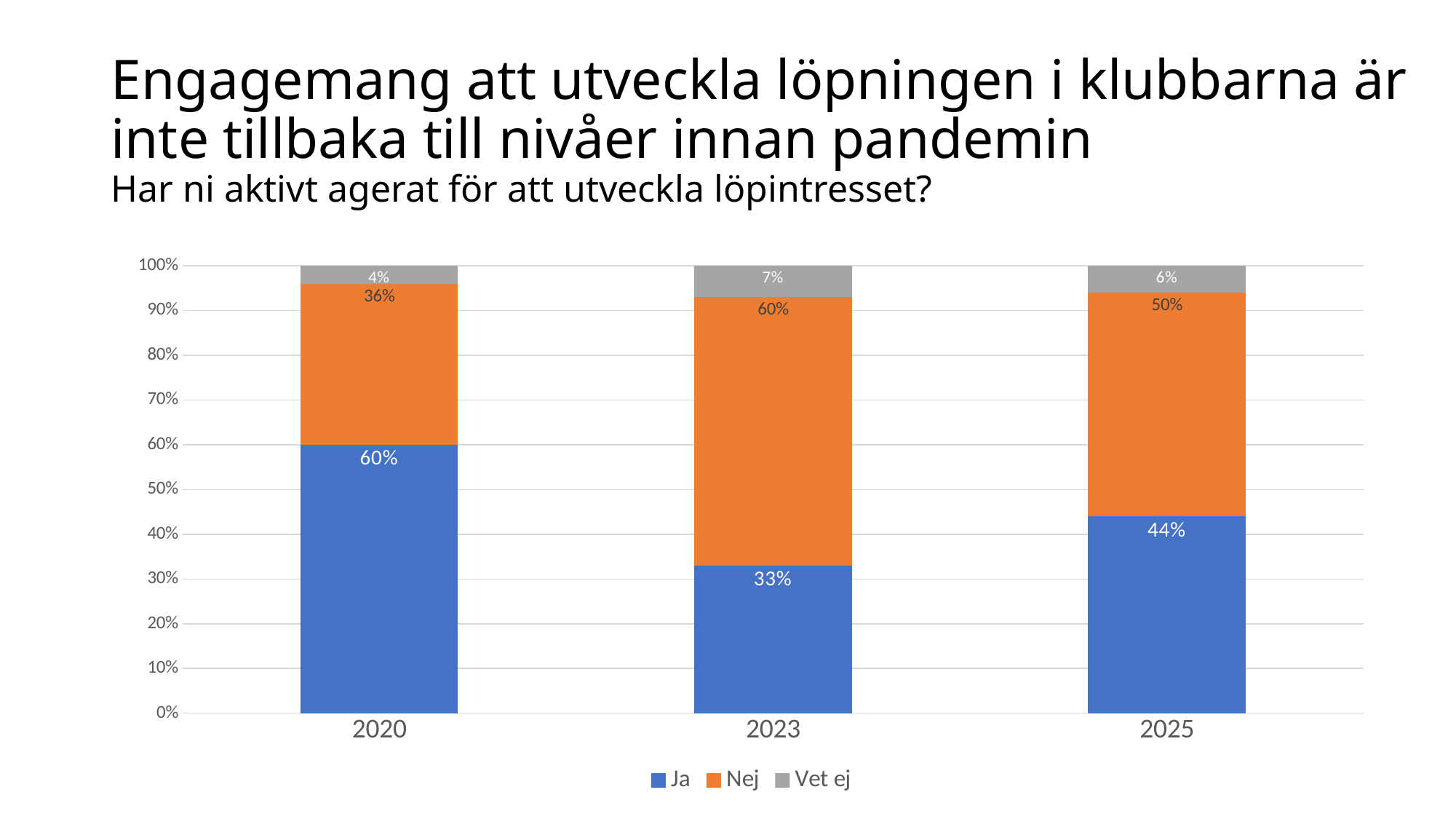
What is the value for Vet ej in 2025? 6% In which year is the Ja share lowest? 2023 What is the value for Ja in 2020? 60% Which colour represents Nej in the chart? Orange What is the difference between the Ja value in 2020 and the Ja value in 2023? 27% How many years are shown on the x axis? 3 What is the value for Nej in 2023? 60% What is the value for Ja in 2025? 44% In which year is the Nej share highest? 2023 What kind of chart is shown on the slide? Stacked bar chart Which is larger in 2025, Ja or Nej? Nej How many series does the legend list? 3